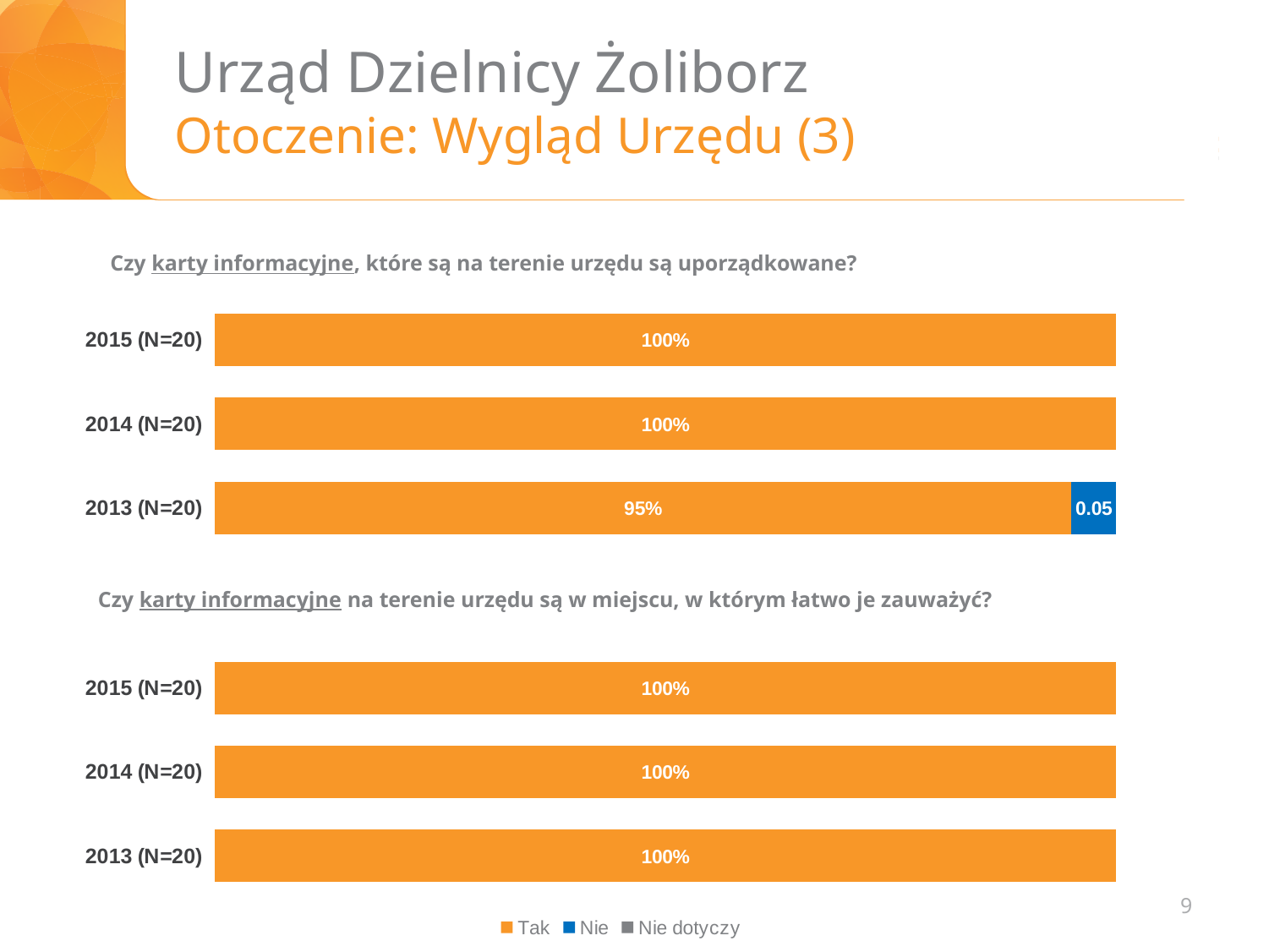
How many year categories does the bottom chart ("Czy karty informacyjne na terenie urzędu są w miejscu, w którym łatwo je zauważyć?") show? 3 In the top chart ("Czy karty informacyjne, które są na terenie urzędu są uporządkowane?"), which is larger, the Tak value for 2015 (N=20) or for 2013 (N=20)? 2015 (N=20) In the top chart ("Czy karty informacyjne, które są na terenie urzędu są uporządkowane?"), what value is printed on the Nie segment for 2013 (N=20)? 0.05 In the top chart ("Czy karty informacyjne, które są na terenie urzędu są uporządkowane?"), which year has the lowest Tak value? 2013 (N=20) How many series does the legend at the bottom of the slide list? 3 What are the legend entries shown at the bottom of the slide? Tak, Nie, Nie dotyczy In the top chart ("Czy karty informacyjne, które są na terenie urzędu są uporządkowane?"), what is the value for Tak in 2013 (N=20)? 95% What kind of chart is the top chart ("Czy karty informacyjne, które są na terenie urzędu są uporządkowane?")? Stacked horizontal bar chart In the top chart ("Czy karty informacyjne, które są na terenie urzędu są uporządkowane?"), what is the difference between the Tak value for 2014 (N=20) and 2013 (N=20)? 5% In the bottom chart ("Czy karty informacyjne na terenie urzędu są w miejscu, w którym łatwo je zauważyć?"), what is the value for Tak in 2014 (N=20)? 100% In the top chart ("Czy karty informacyjne, które są na terenie urzędu są uporządkowane?"), what is the value for Tak in 2015 (N=20)? 100% In the bottom chart ("Czy karty informacyjne na terenie urzędu są w miejscu, w którym łatwo je zauważyć?"), what is the value for Tak in 2013 (N=20)? 100%